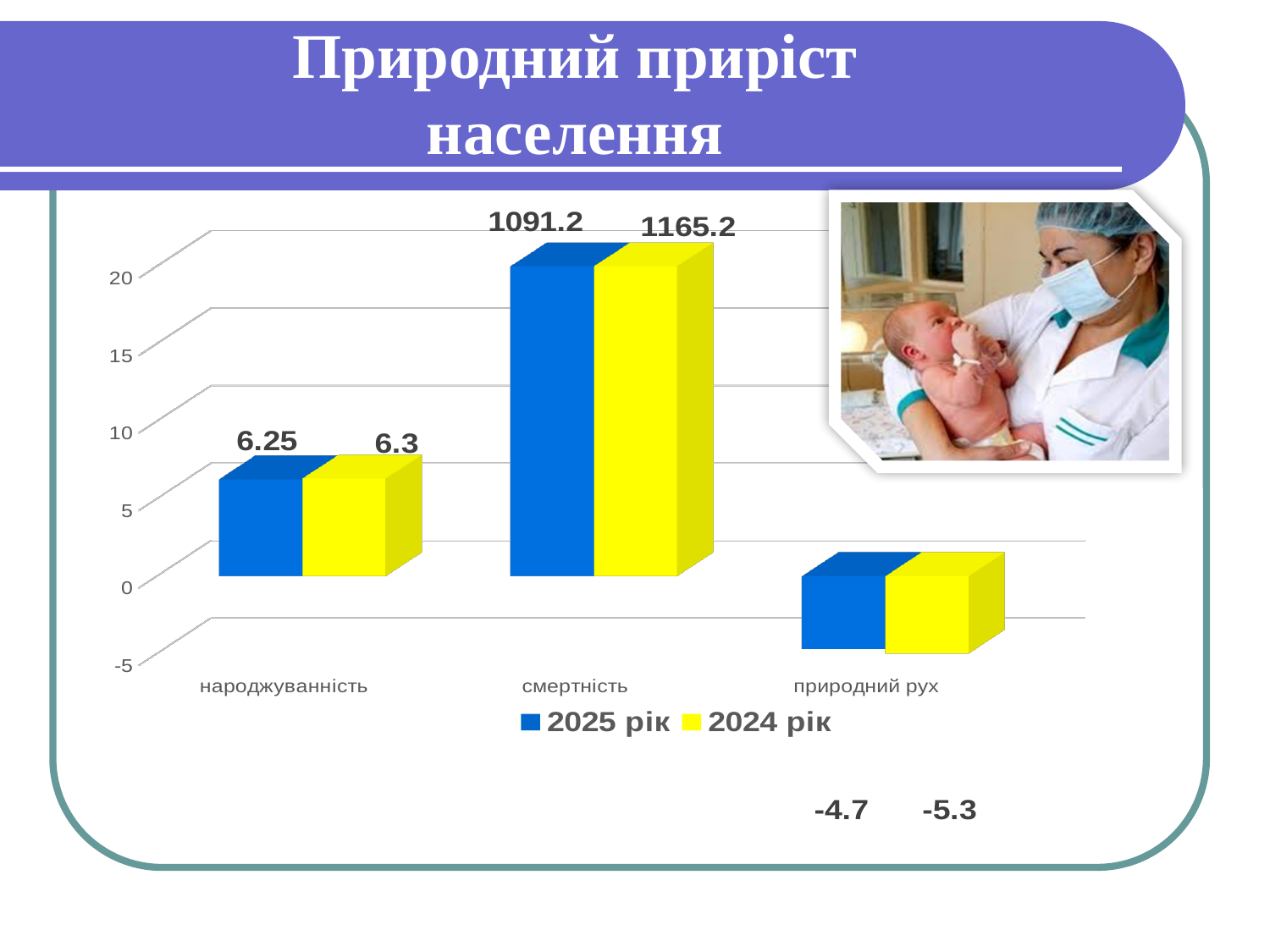
What are the two series named in the chart legend? 2025 рік and 2024 рік How many categories are shown on the x axis of the chart? 3 What is the value labelled for смертність in the 2024 рік series? 1165.2 What is the value labelled for природний рух in the 2024 рік series? -5.3 Which category has the lowest bars in the chart? природний рух Which category has the highest bars in the chart? смертність What kind of chart is shown on the slide? bar chart What is the value labelled for природний рух in the 2025 рік series? -4.7 What is the value labelled for народжуваність in the 2024 рік series? 6.3 How many series does the chart legend list? 2 What is the value labelled for смертність in the 2025 рік series? 1091.2 What is the value labelled for народжуваність in the 2025 рік series? 6.25